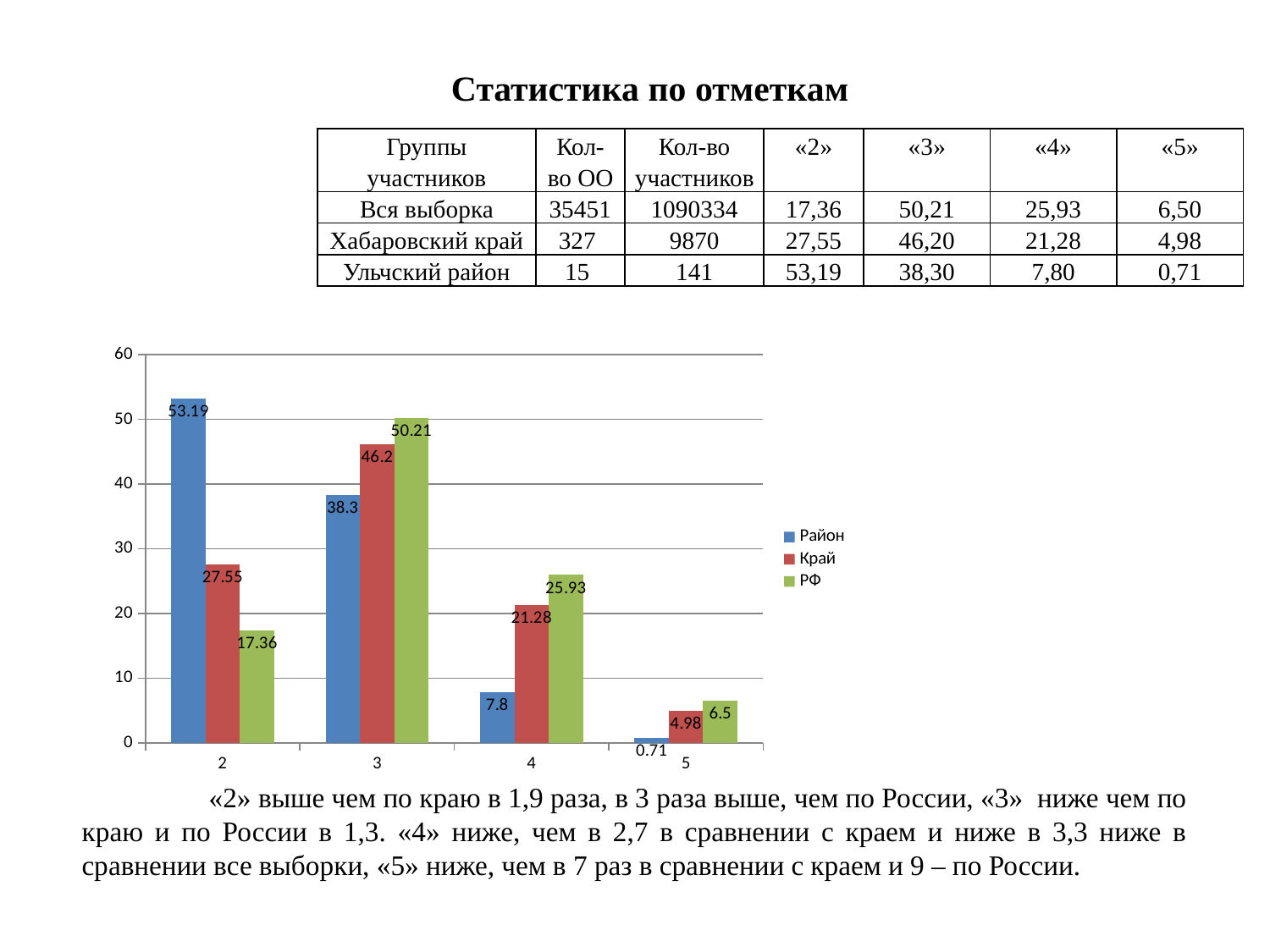
What is the value for РФ in category 3? 50.21 What is the difference between the Край and РФ values in category 2? 10.19 Which series is shown in green in the chart legend? РФ How many series does the chart legend list? 3 In which category is the РФ series lowest? 5 In which category is the Район series highest? 2 What is the value for Район in category 5? 0.71 What is the value for Район in category 2? 53.19 What kind of chart is shown on the slide? bar chart Which is larger in category 3: Район or Край? Край How many categories are shown on the x axis of the chart? 4 What is the value for Край in category 4? 21.28